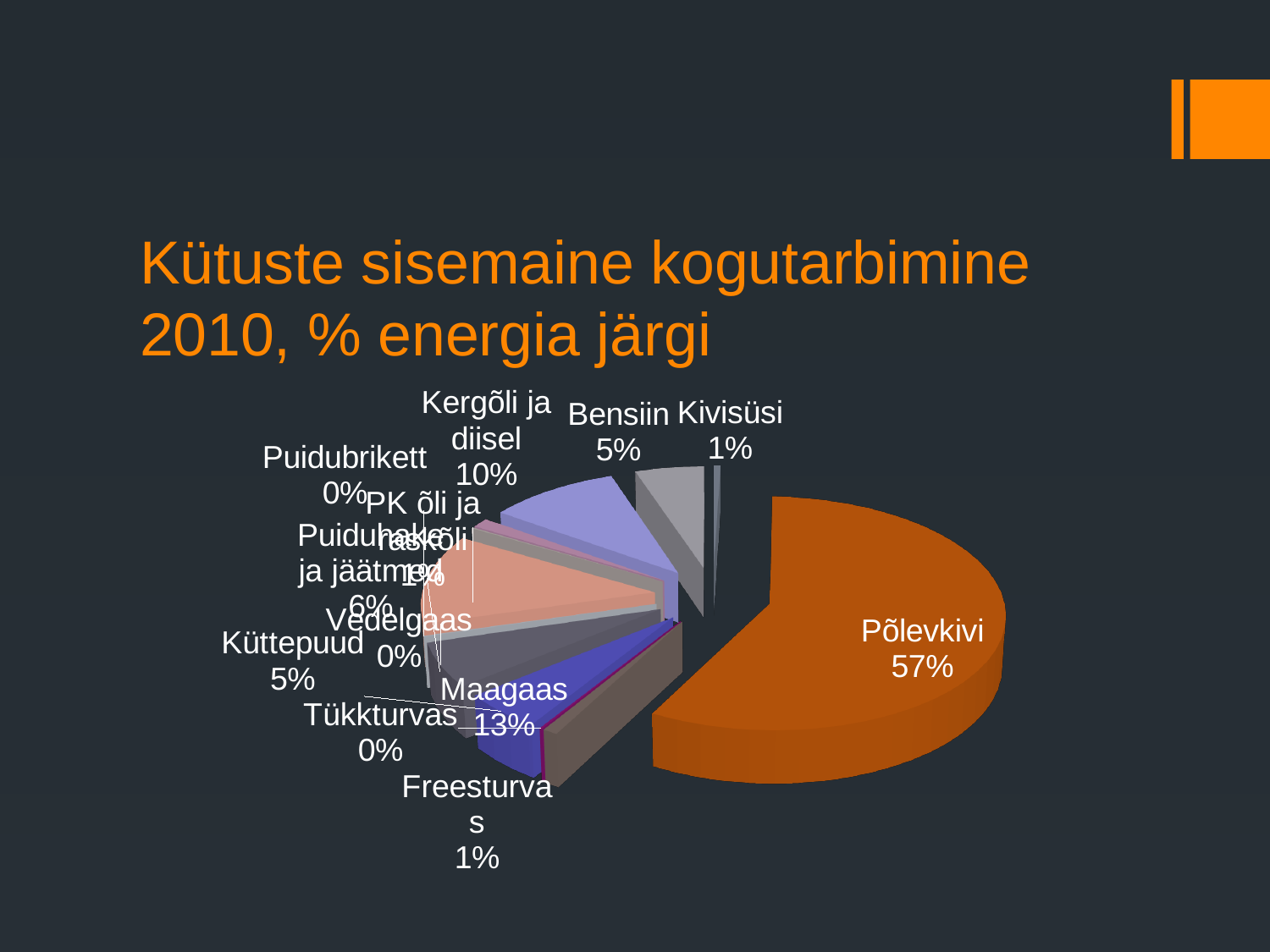
What is the title of the slide? Kütuste sisemaine kogutarbimine 2010, % energia järgi What is the value shown for Maagaas? 13% What share of the pie does Põlevkivi account for? 57% How many percentage points larger is Põlevkivi than Maagaas? 44 What is the value shown for Bensiin? 5% What percentage is shown for Freesturvas? 1% Which category has the largest share of the pie? Põlevkivi Which is larger, Maagaas or Kergõli ja diisel? Maagaas What is the value shown for Küttepuud? 5% What kind of chart is shown on the slide? Pie chart What percentage is shown for Kivisüsi? 1% What percentage is shown for Kergõli ja diisel? 10%